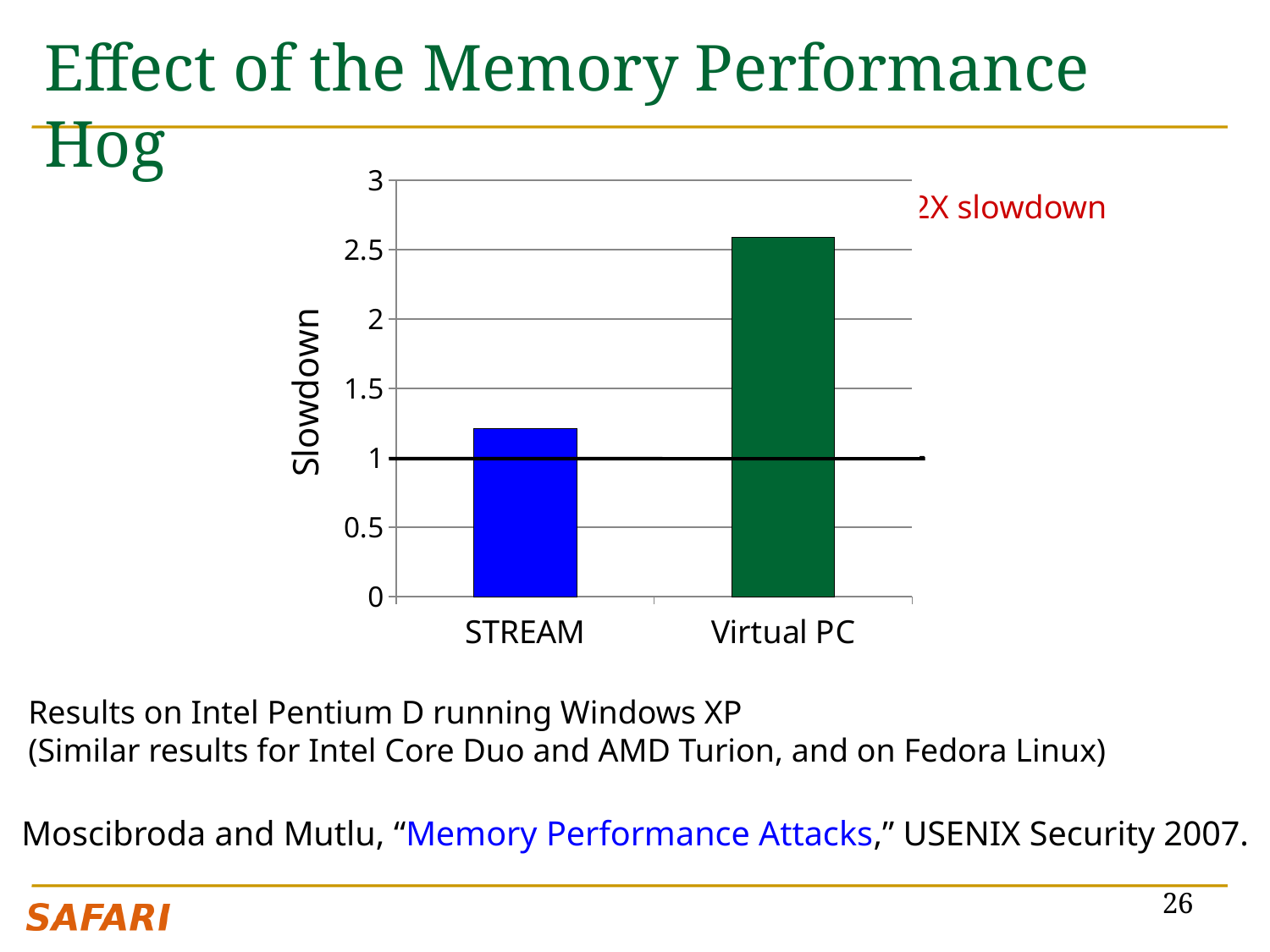
Which has a larger slowdown, STREAM or Virtual PC? Virtual PC Which category has the lowest slowdown? STREAM Is the slowdown for STREAM greater or less than 1? greater Which category has the highest slowdown? Virtual PC Is the slowdown for Virtual PC greater or less than 2? greater Is the slowdown for Virtual PC greater or less than 3? less What colour is the bar for Virtual PC? green What is the label of the y axis? Slowdown How many categories are plotted on the x axis? 2 What kind of chart is shown on the slide? bar chart